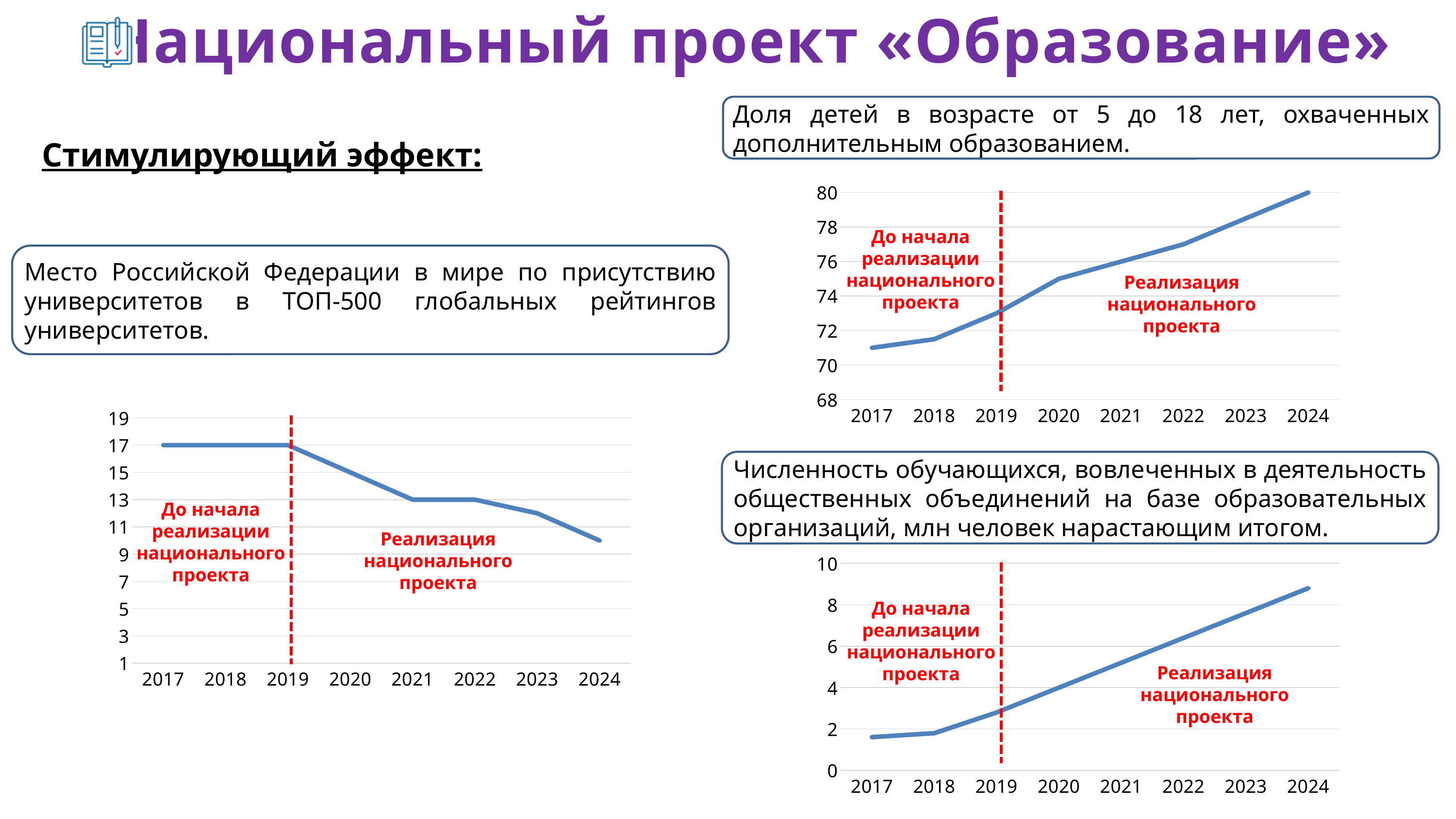
In the left chart (place of the Russian Federation in TOP-500 rankings), what is the difference between the values for 2019 and 2022? 4 In the bottom-right chart (number of students involved in public associations, million people), do the values rise or fall from 2017 to 2024? rise What kind of chart is the chart on the left of the slide (place of the Russian Federation in TOP-500 rankings)? line chart In the left chart (place of the Russian Federation in TOP-500 rankings), do the values rise or fall from 2019 to 2024? fall How many years are shown on the x axis of the left chart (place of the Russian Federation in TOP-500 rankings)? 8 In the left chart (place of the Russian Federation in TOP-500 rankings), what is the value for 2017? 17 In the top-right chart (share of children aged 5 to 18 covered by additional education), what is the value for 2024? 80 In the left chart (place of the Russian Federation in TOP-500 rankings), is the value for 2024 greater or less than 11? less In the top-right chart (share of children aged 5 to 18 covered by additional education), which year has the highest value? 2024 In the top-right chart (share of children aged 5 to 18 covered by additional education), is the value for 2017 greater or less than 72? less In the left chart (place of the Russian Federation in TOP-500 rankings), what is the value for 2021? 13 In the bottom-right chart (number of students involved in public associations, million people), is the value for 2024 greater or less than 8? greater